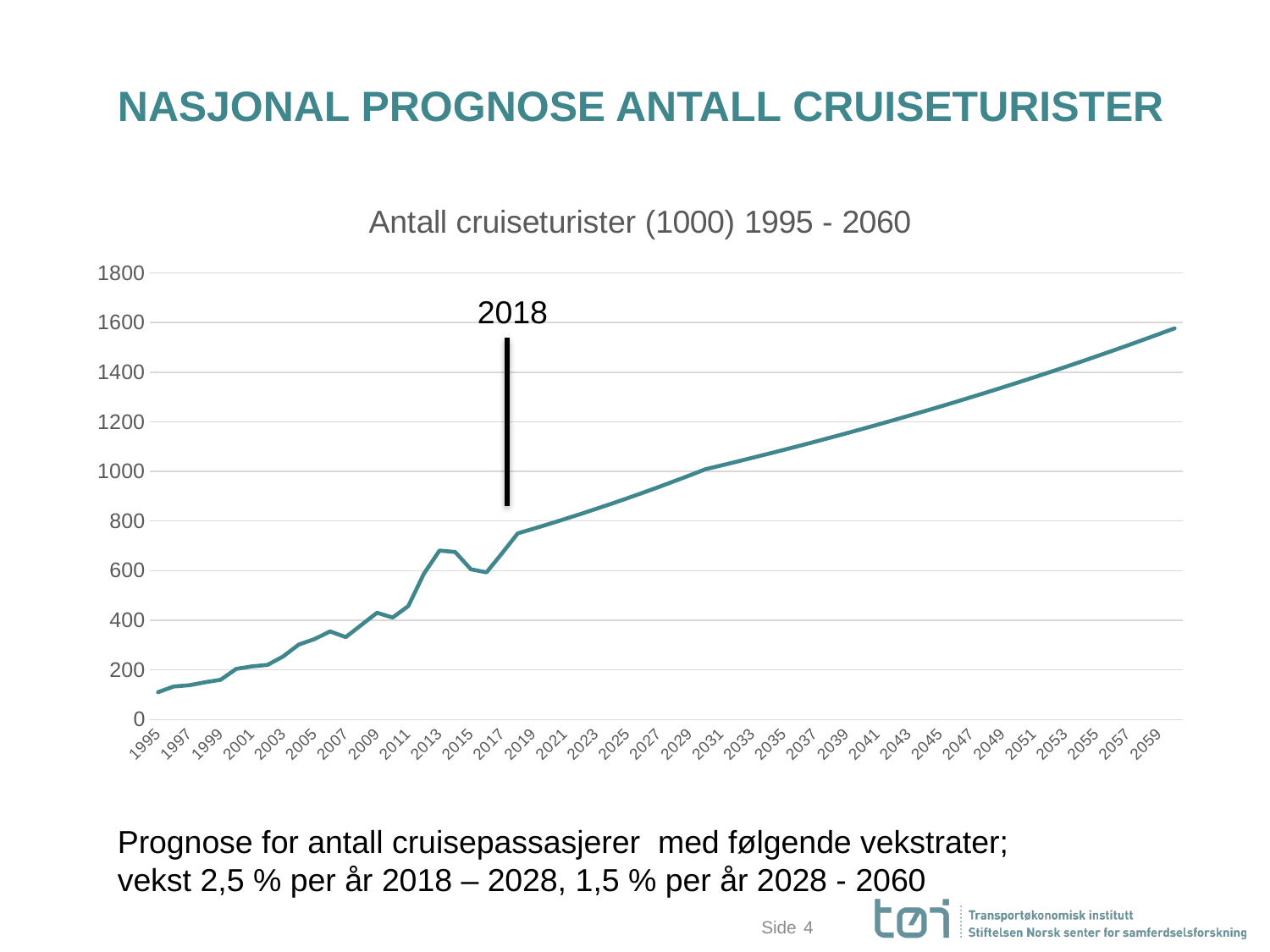
Which year has the highest value on the chart? 2060 Which year has the lowest value on the chart? 1995 Is the value for 1995 greater or less than 200? less Is the value for 2059 greater or less than 1400? greater Is the value for 2025 greater or less than 1000? less Overall, do the values rise or fall from 1995 to 2059? rise Which year is marked by the vertical black line annotation on the chart? 2018 What is the title of the chart? Antall cruiseturister (1000) 1995 - 2060 What kind of chart is shown on the slide? line chart